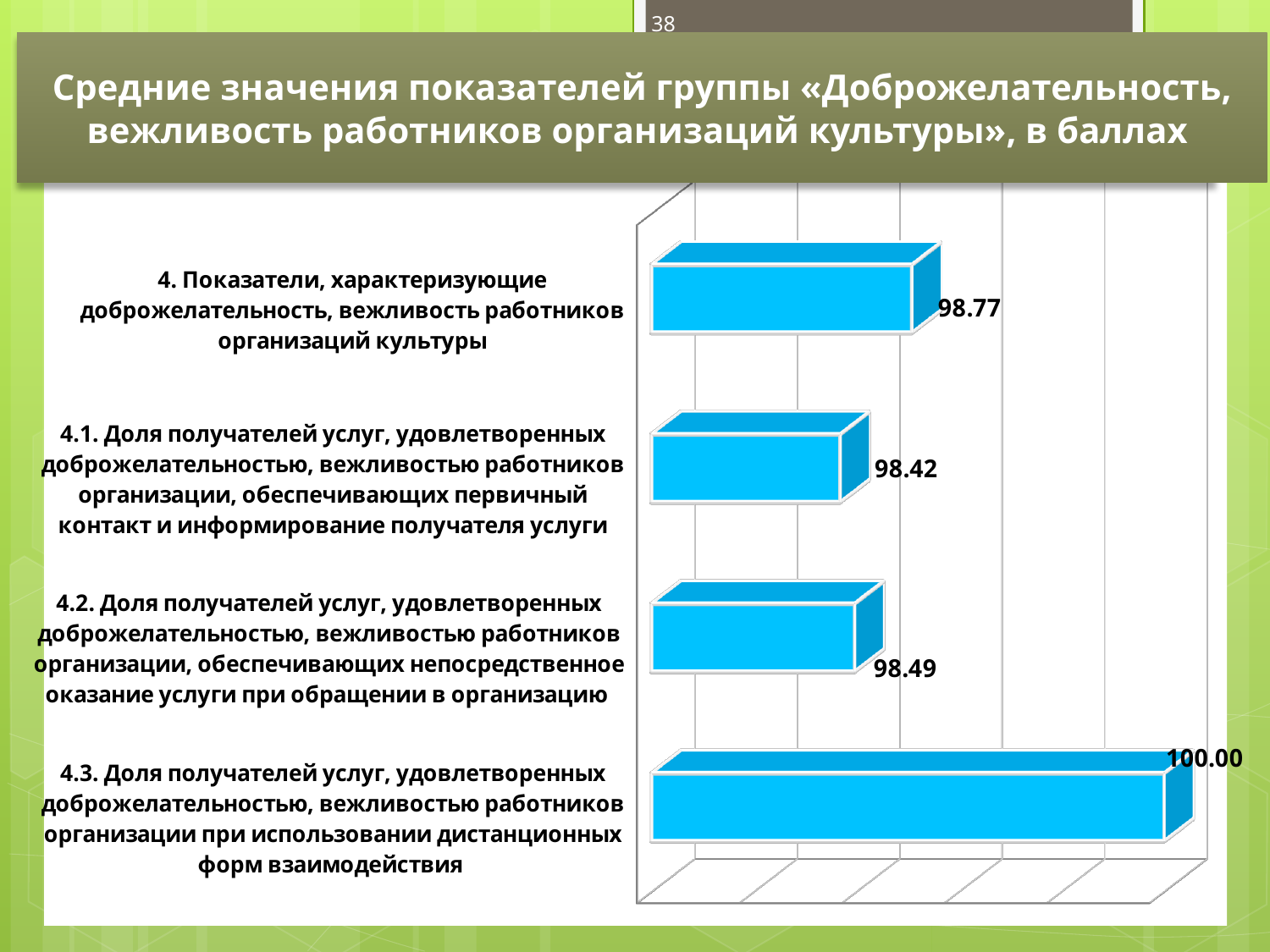
Which indicator has the highest value? 4.3 How many indicators (bars) are shown in the chart? 4 What is the difference between the value for indicator 4 and the value for indicator 4.1? 0.35 What is the value for indicator 4.1 (satisfaction with friendliness of staff providing first contact and information)? 98.42 What is the difference between the values for indicator 4.3 and indicator 4.1? 1.58 What is the value for indicator 4.2 (satisfaction with friendliness of staff directly providing the service)? 98.49 What is the value for indicator 4.3 (satisfaction with staff friendliness when using remote forms of interaction)? 100.00 Which indicator has the lowest value? 4.1 What kind of chart is shown on the slide? Bar chart Which is larger, the value for indicator 4.2 or the value for indicator 4.1? 4.2 What colour are the bars in the chart? Blue What is the value for the overall group indicator 4 (indicators characterising friendliness and politeness of cultural organisation staff)? 98.77